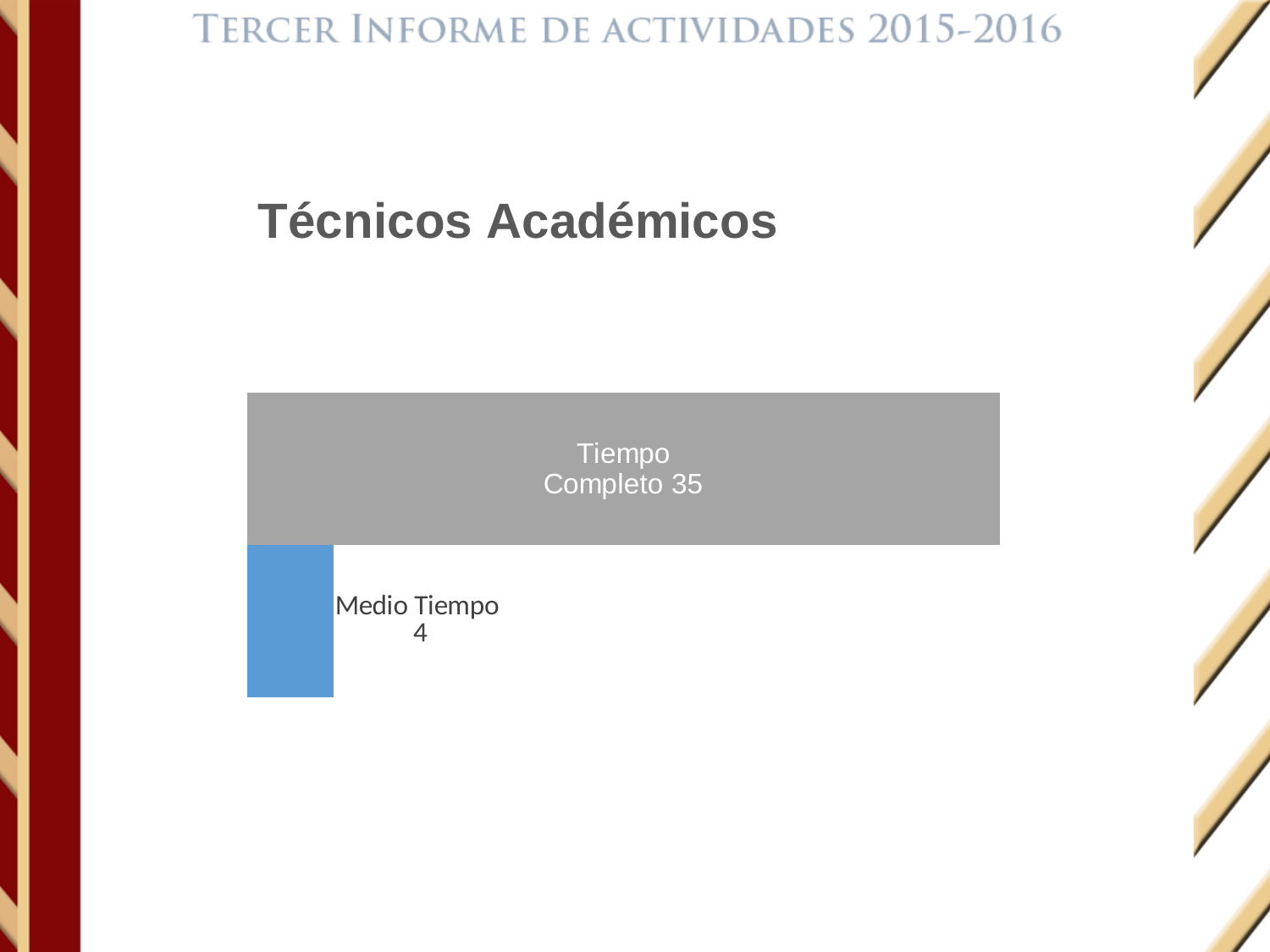
What colour is the bar for Medio Tiempo? blue Which category has the lowest value? Medio Tiempo What kind of chart is shown on the slide? bar chart Which category has the highest value? Tiempo Completo What is the value for Tiempo Completo? 35 What is the value for Medio Tiempo? 4 What is the total of the two values shown in the chart? 39 What is the title of the slide above the chart? Técnicos Académicos How many categories are shown in the chart? 2 What is the difference between the values for Tiempo Completo and Medio Tiempo? 31 Which is larger, the value for Tiempo Completo or the value for Medio Tiempo? Tiempo Completo